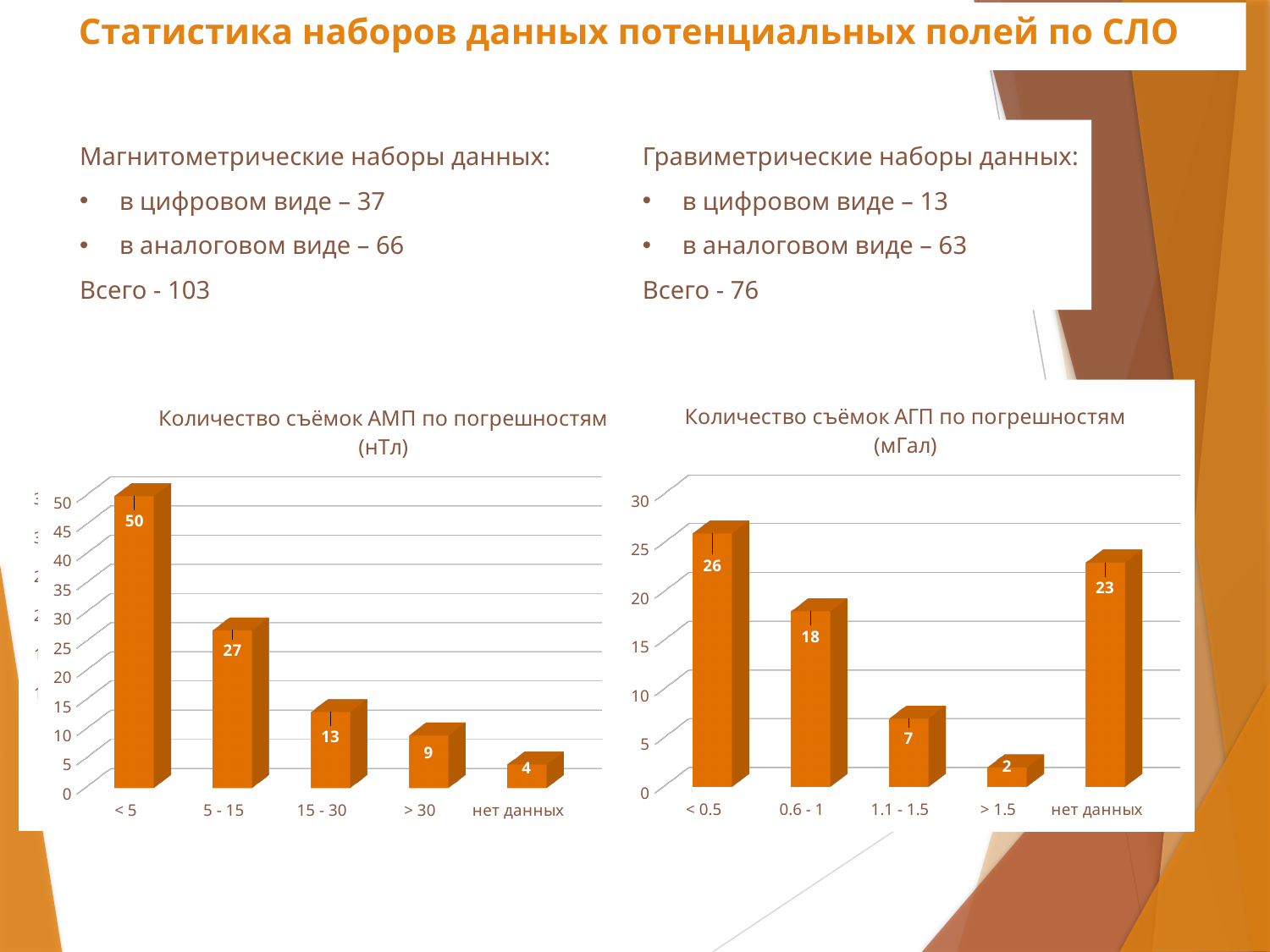
In the chart 'Количество съёмок АМП по погрешностям (нТл)', what is the value for the category '> 30'? 9 In the chart 'Количество съёмок АМП по погрешностям (нТл)', how many categories are shown on the x axis? 5 In the chart 'Количество съёмок АГП по погрешностям (мГал)', what is the value for the category '0.6 - 1'? 18 In the chart 'Количество съёмок АМП по погрешностям (нТл)', what is the value for the category '< 5'? 50 What kind of chart is 'Количество съёмок АГП по погрешностям (мГал)'? bar chart In the chart 'Количество съёмок АГП по погрешностям (мГал)', which category has the highest value? < 0.5 In the chart 'Количество съёмок АГП по погрешностям (мГал)', which is larger: the value for '1.1 - 1.5' or the value for 'нет данных'? нет данных In the chart 'Количество съёмок АМП по погрешностям (нТл)', do the values rise or fall from left to right along the x axis? fall In the chart 'Количество съёмок АМП по погрешностям (нТл)', which category has the lowest value? нет данных In the chart 'Количество съёмок АГП по погрешностям (мГал)', which category has the lowest value? > 1.5 In the chart 'Количество съёмок АМП по погрешностям (нТл)', what is the difference between the values for '5 - 15' and '15 - 30'? 14 In the chart 'Количество съёмок АГП по погрешностям (мГал)', what is the difference between the values for '< 0.5' and 'нет данных'? 3